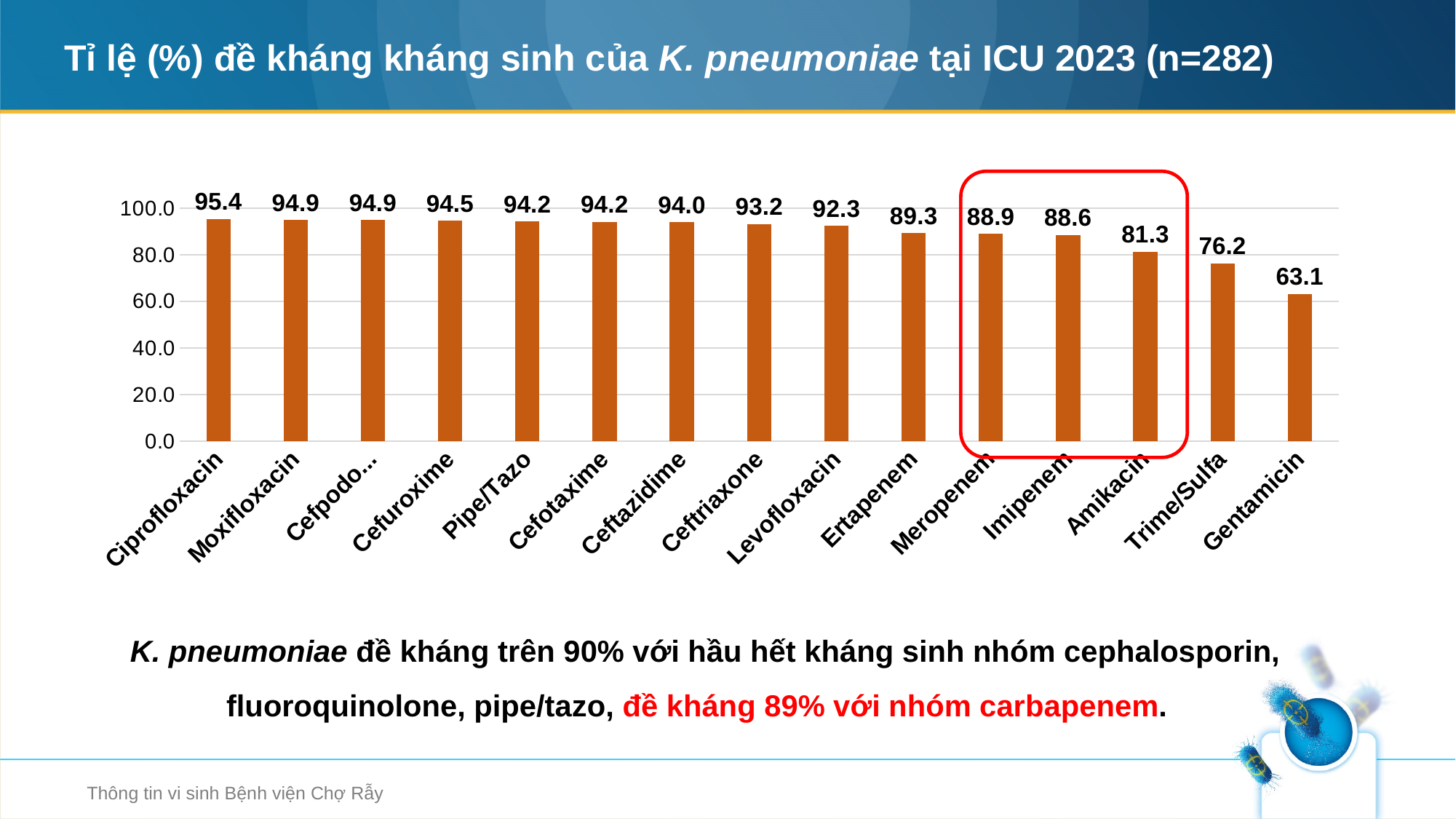
Which has a larger value, Trime/Sulfa or Amikacin? Amikacin What is the value shown for Meropenem? 88.9 What is the value shown for Amikacin? 81.3 What is the difference between the values for Ciprofloxacin and Gentamicin? 32.3 Which antibiotic has the lowest resistance rate? Gentamicin How many antibiotics are shown on the x axis? 15 What is the difference between the values for Ertapenem and Imipenem? 0.7 Which antibiotic has the highest resistance rate? Ciprofloxacin Do the values rise or fall from left to right along the x axis? Fall What is the value shown for Gentamicin? 63.1 What kind of chart is shown on the slide? Bar chart What is the resistance rate for Ciprofloxacin? 95.4